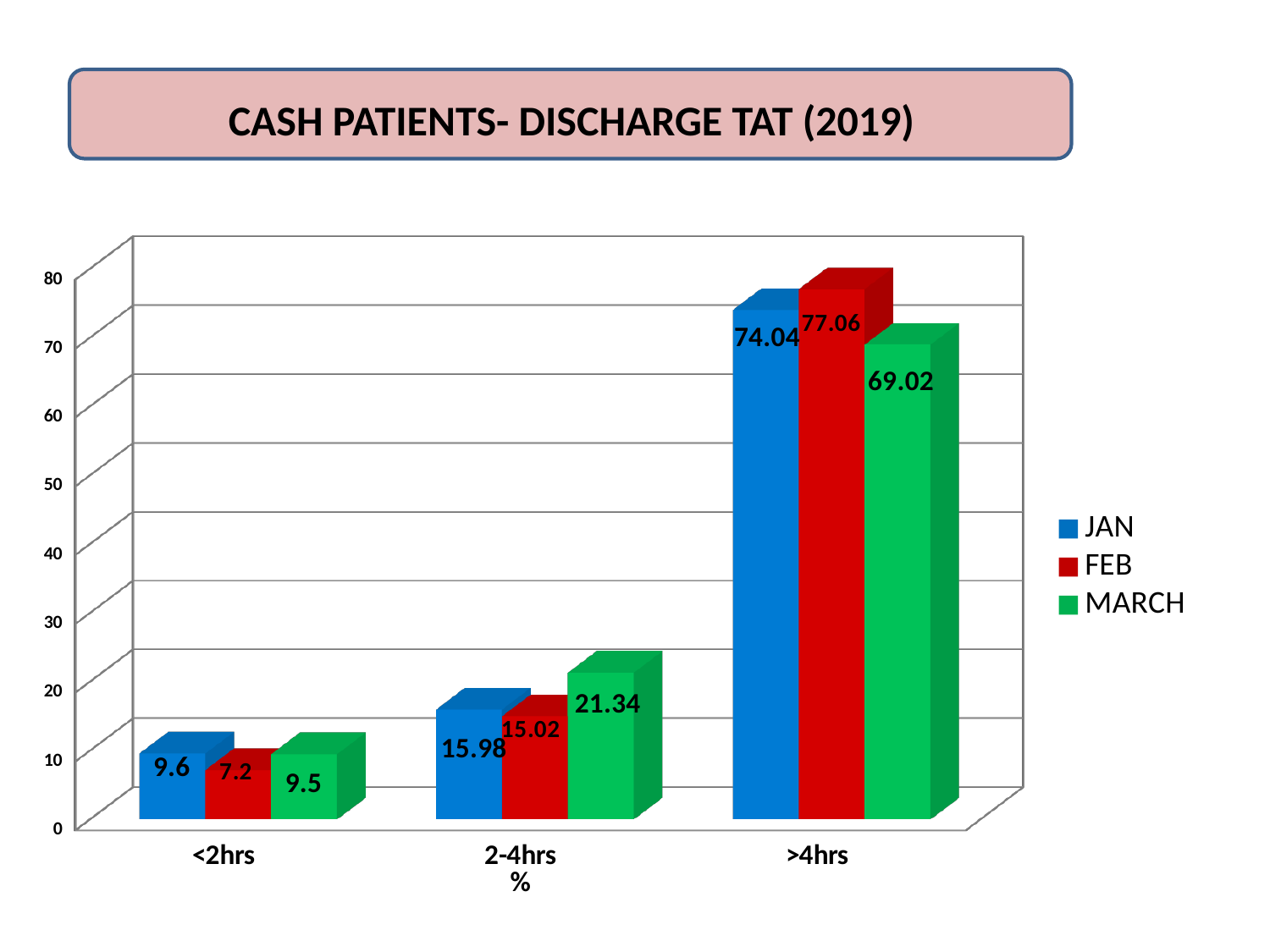
Which is larger in the 2-4hrs category, the JAN value or the FEB value? JAN Is the value for JAN in the >4hrs category greater or less than 70? greater How many series does the legend list? 3 What kind of chart is shown on the slide? bar chart What is the value for FEB in the >4hrs category? 77.06 How many categories are shown on the x axis? 3 What is the difference between the FEB and MARCH values in the >4hrs category? 8.04 Which month has the highest value in the >4hrs category? FEB What is the value for MARCH in the 2-4hrs category? 21.34 What is the title of the slide? CASH PATIENTS- DISCHARGE TAT (2019) What is the value for JAN in the <2hrs category? 9.6 Which month has the lowest value in the <2hrs category? FEB